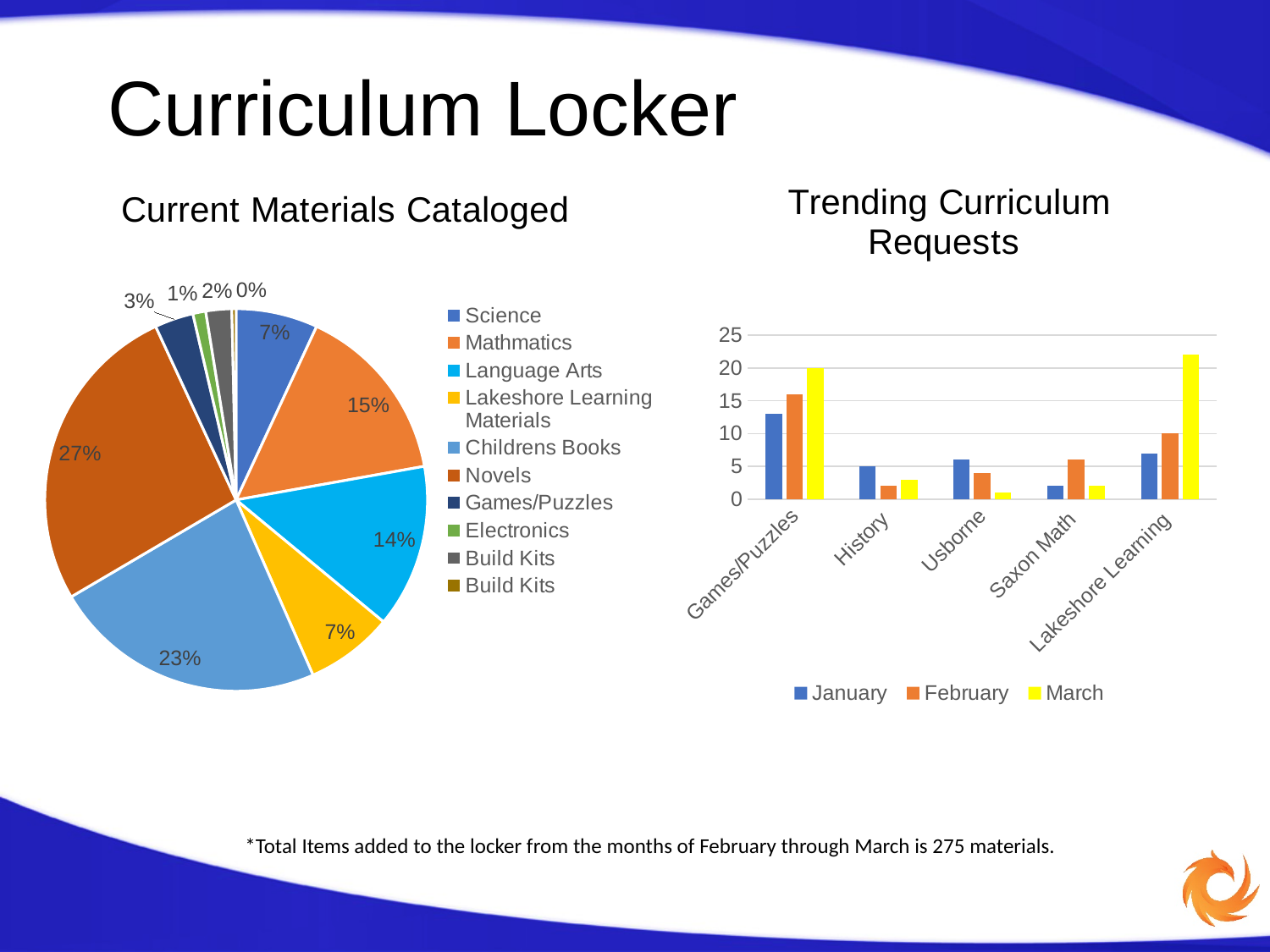
On the Trending Curriculum Requests chart, is the March value for Lakeshore Learning greater or less than 20? greater On the Current Materials Cataloged chart, what percentage is Novels? 27% On the Trending Curriculum Requests chart, how many series does the legend list? 3 On the Trending Curriculum Requests chart, how many categories are shown on the x axis? 5 On the Current Materials Cataloged chart, what percentage is Childrens Books? 23% What kind of chart is Trending Curriculum Requests? Bar chart On the Current Materials Cataloged chart, how many percentage points larger is Novels than Childrens Books? 4 On the Current Materials Cataloged chart, which is larger, Mathmatics or Language Arts? Mathmatics On the Current Materials Cataloged chart, which category has the largest share? Novels What kind of chart is Current Materials Cataloged? Pie chart On the Trending Curriculum Requests chart, is the February value for History greater or less than 5? less On the Trending Curriculum Requests chart, what is the March value for Games/Puzzles? 20